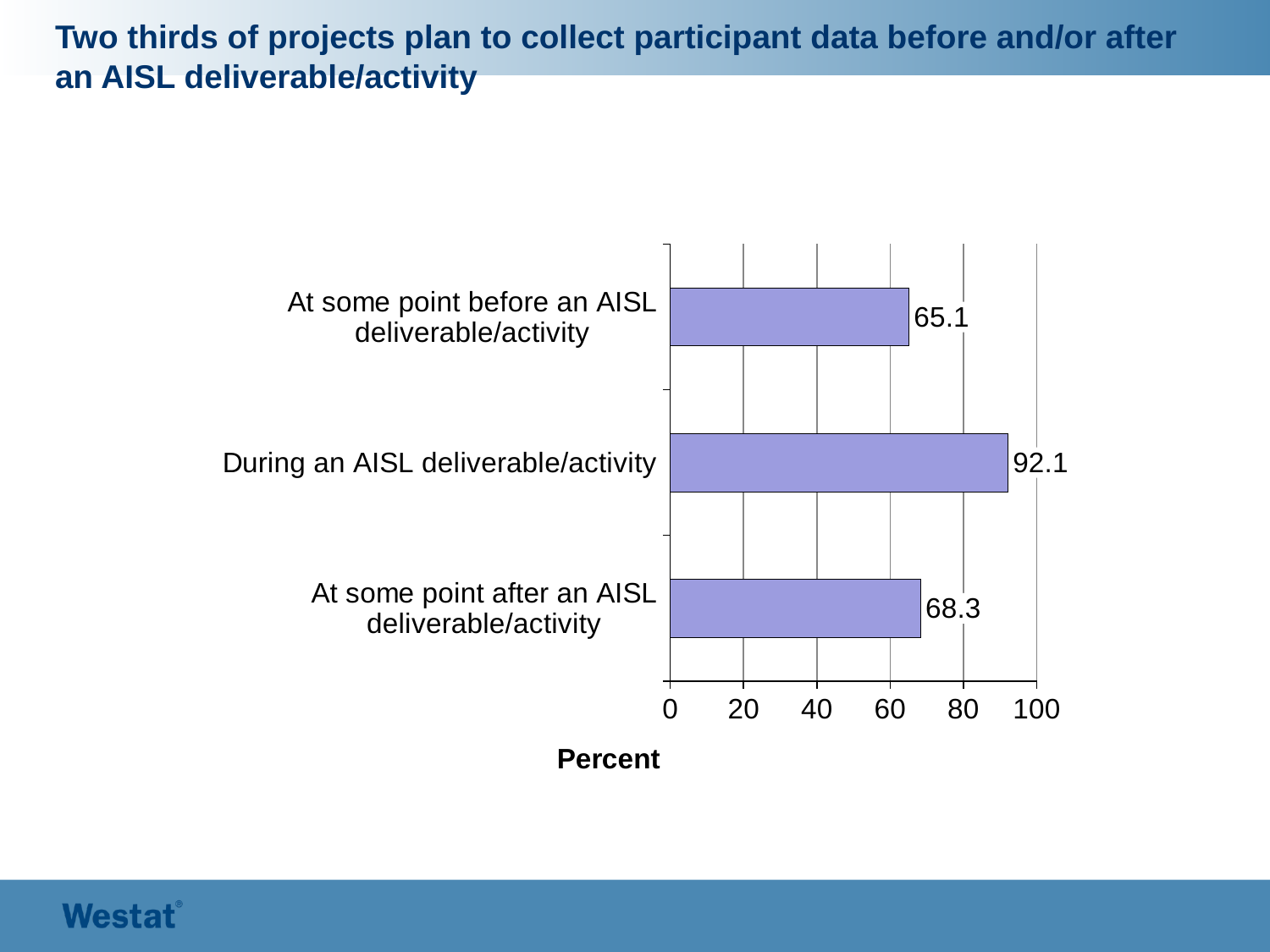
Which category has the lowest value? At some point before an AISL deliverable/activity What is the difference between the values for "At some point after an AISL deliverable/activity" and "At some point before an AISL deliverable/activity"? 3.2 What is the difference between the values for "During an AISL deliverable/activity" and "At some point before an AISL deliverable/activity"? 27.0 What kind of chart is shown on the slide? Bar chart How many categories are shown in the chart? 3 Which is larger: the value for "At some point after an AISL deliverable/activity" or "At some point before an AISL deliverable/activity"? At some point after an AISL deliverable/activity Which category has the highest value? During an AISL deliverable/activity What is the label on the horizontal axis of the chart? Percent What is the value for "At some point before an AISL deliverable/activity"? 65.1 What is the value for "At some point after an AISL deliverable/activity"? 68.3 What is the value for "During an AISL deliverable/activity"? 92.1 Is the value for "During an AISL deliverable/activity" greater or less than 80? greater